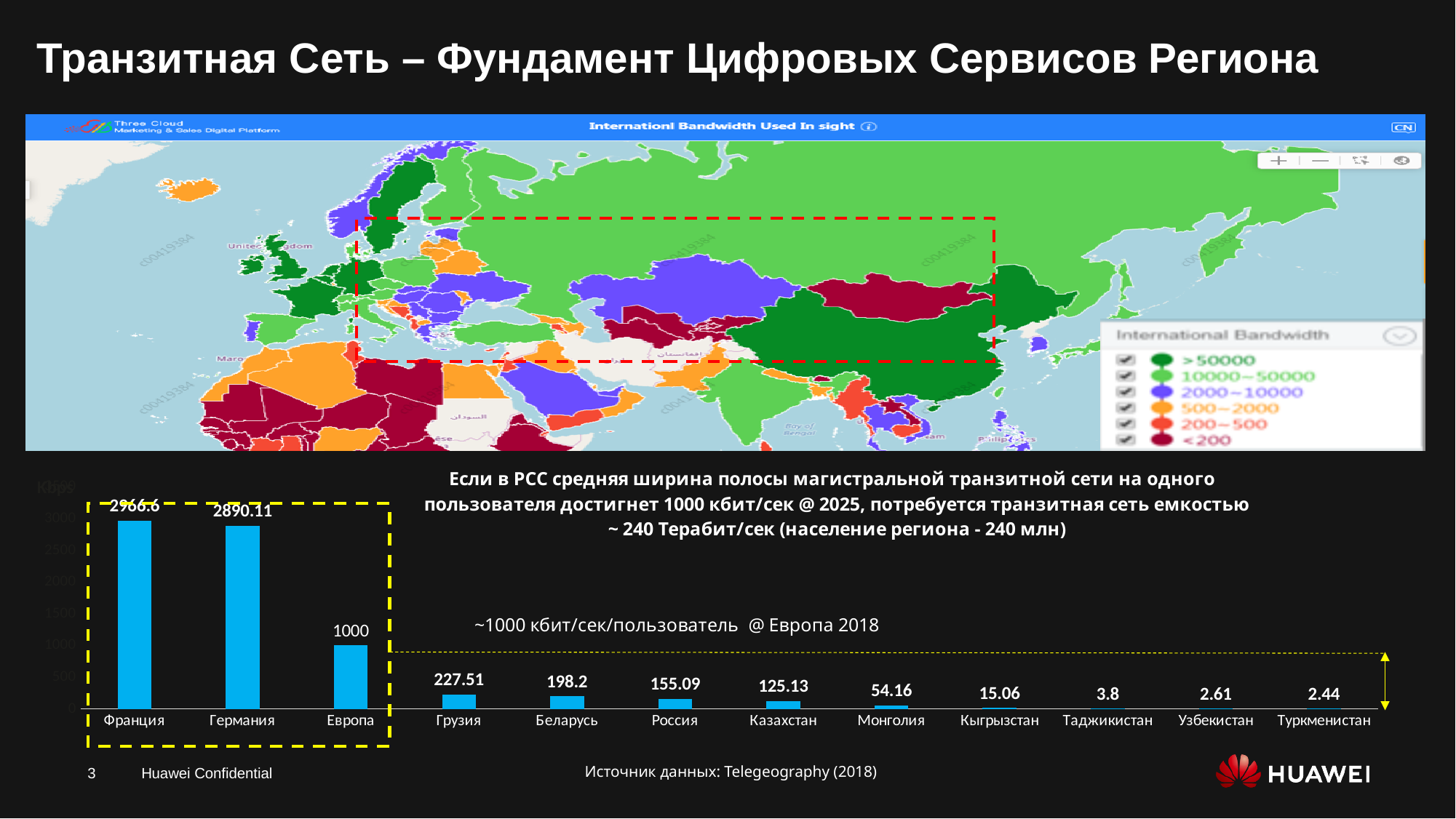
Which category has the lowest value in the bar chart? Туркменистан What type of chart is shown at the bottom of the slide? bar chart In the bar chart, is the value for Европа greater or less than 500? greater In the bar chart, what is the difference between the values for Грузия and Беларусь? 29.31 Which category has the highest value in the bar chart? Франция In the bar chart, what is the value for Германия? 2890.11 In the bar chart, which is larger: the value for Казахстан or the value for Монголия? Казахстан In the bar chart, what is the value for Франция? 2966.6 In the bar chart, what is the value for Россия? 155.09 How many categories are shown on the x axis of the bar chart? 12 In the bar chart, what is the value for Туркменистан? 2.44 In the bar chart, what is the value for Грузия? 227.51